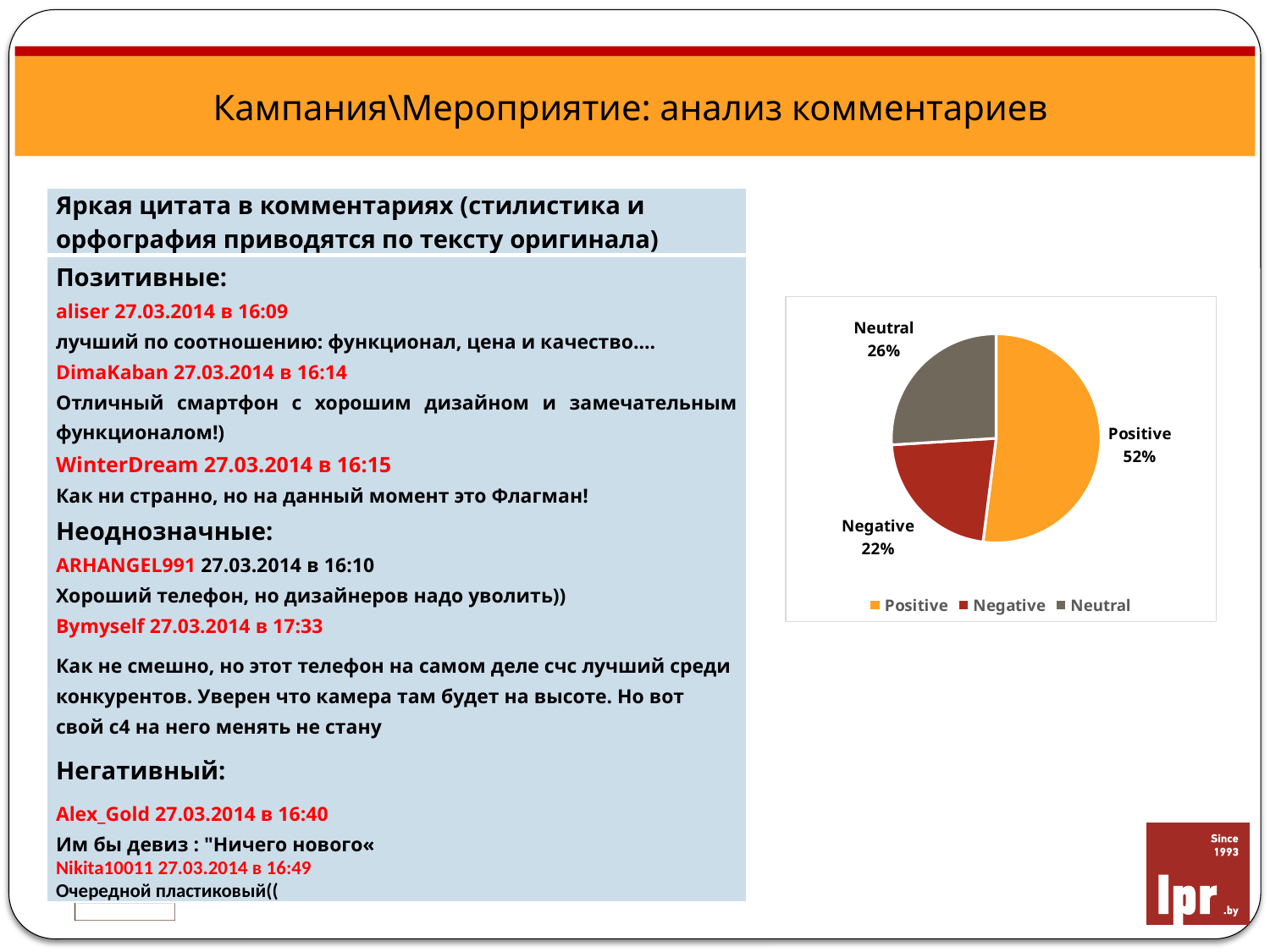
What share of the pie does Positive represent? 52% What share of the pie does Neutral represent? 26% How many entries does the legend list? 3 What kind of chart is shown on the slide? pie chart What is the difference in percentage points between the Neutral and Negative slices? 4 Which category has the largest slice of the pie? Positive How many slices does the pie chart have? 3 What is the difference in percentage points between the Positive and Negative slices? 30 Which slice is larger, Neutral or Negative? Neutral What share of the pie does Negative represent? 22% What colour is the Positive slice in the pie chart? orange Which category has the smallest slice of the pie? Negative